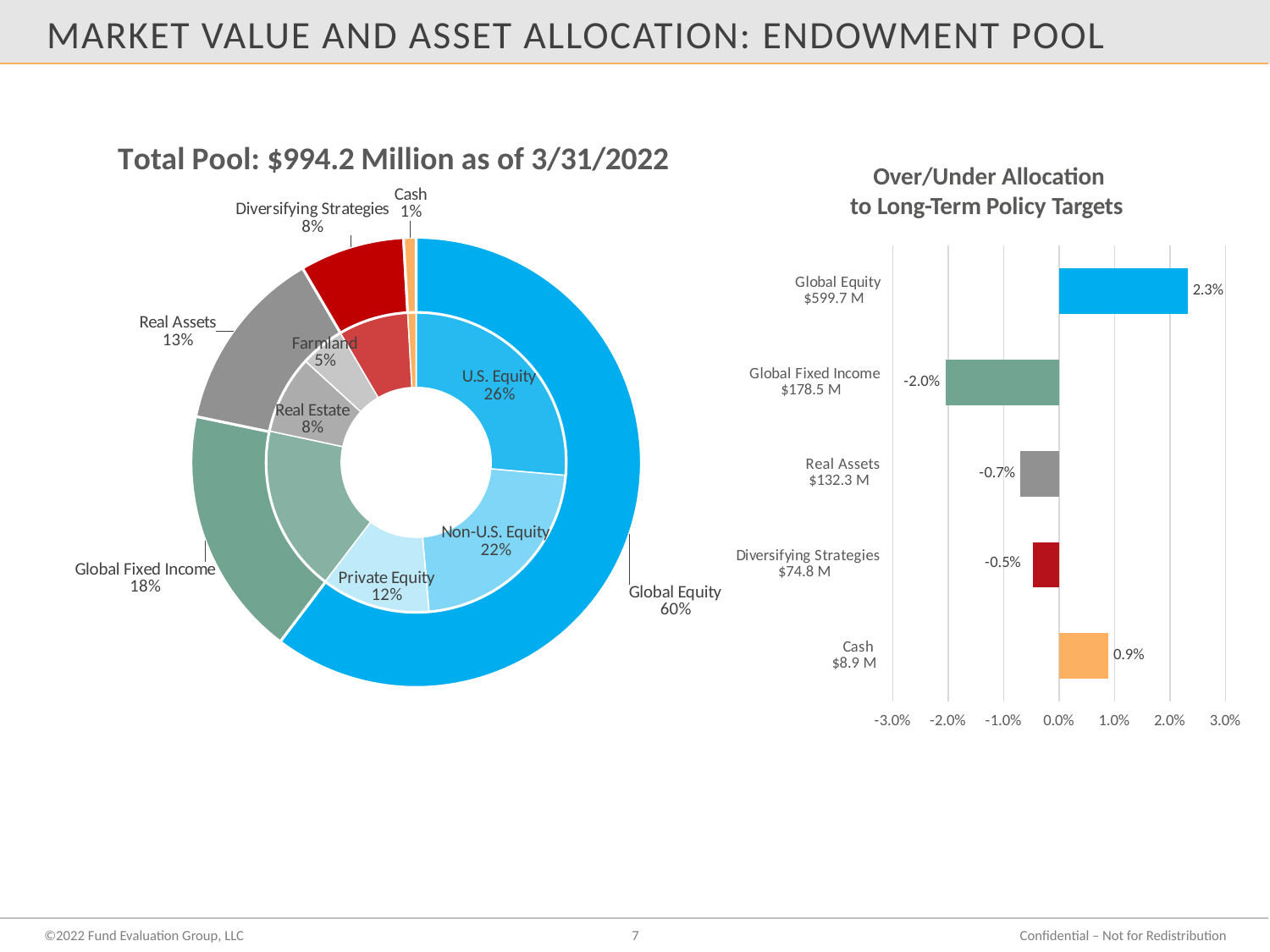
In the 'Total Pool: $994.2 Million as of 3/31/2022' chart, what share of the pool is Private Equity? 12% In the 'Over/Under Allocation to Long-Term Policy Targets' chart, which category has the lowest value? Global Fixed Income In the 'Total Pool: $994.2 Million as of 3/31/2022' chart, which outer-ring category has the largest share? Global Equity In the 'Over/Under Allocation to Long-Term Policy Targets' chart, how many categories are plotted? 5 In the 'Total Pool: $994.2 Million as of 3/31/2022' chart, what is the difference between the U.S. Equity share and the Non-U.S. Equity share? 4% In the 'Total Pool: $994.2 Million as of 3/31/2022' chart, what share of the pool is Global Fixed Income? 18% In the 'Total Pool: $994.2 Million as of 3/31/2022' chart, which outer-ring category has the smallest share? Cash What kind of chart is the 'Over/Under Allocation to Long-Term Policy Targets' chart? Bar chart In the 'Over/Under Allocation to Long-Term Policy Targets' chart, what is the value for Global Fixed Income? -2.0% In the 'Total Pool: $994.2 Million as of 3/31/2022' chart, which is larger, Real Estate or Farmland? Real Estate In the 'Total Pool: $994.2 Million as of 3/31/2022' chart, what share of the pool is Global Equity? 60% In the 'Over/Under Allocation to Long-Term Policy Targets' chart, which category has the highest value? Global Equity